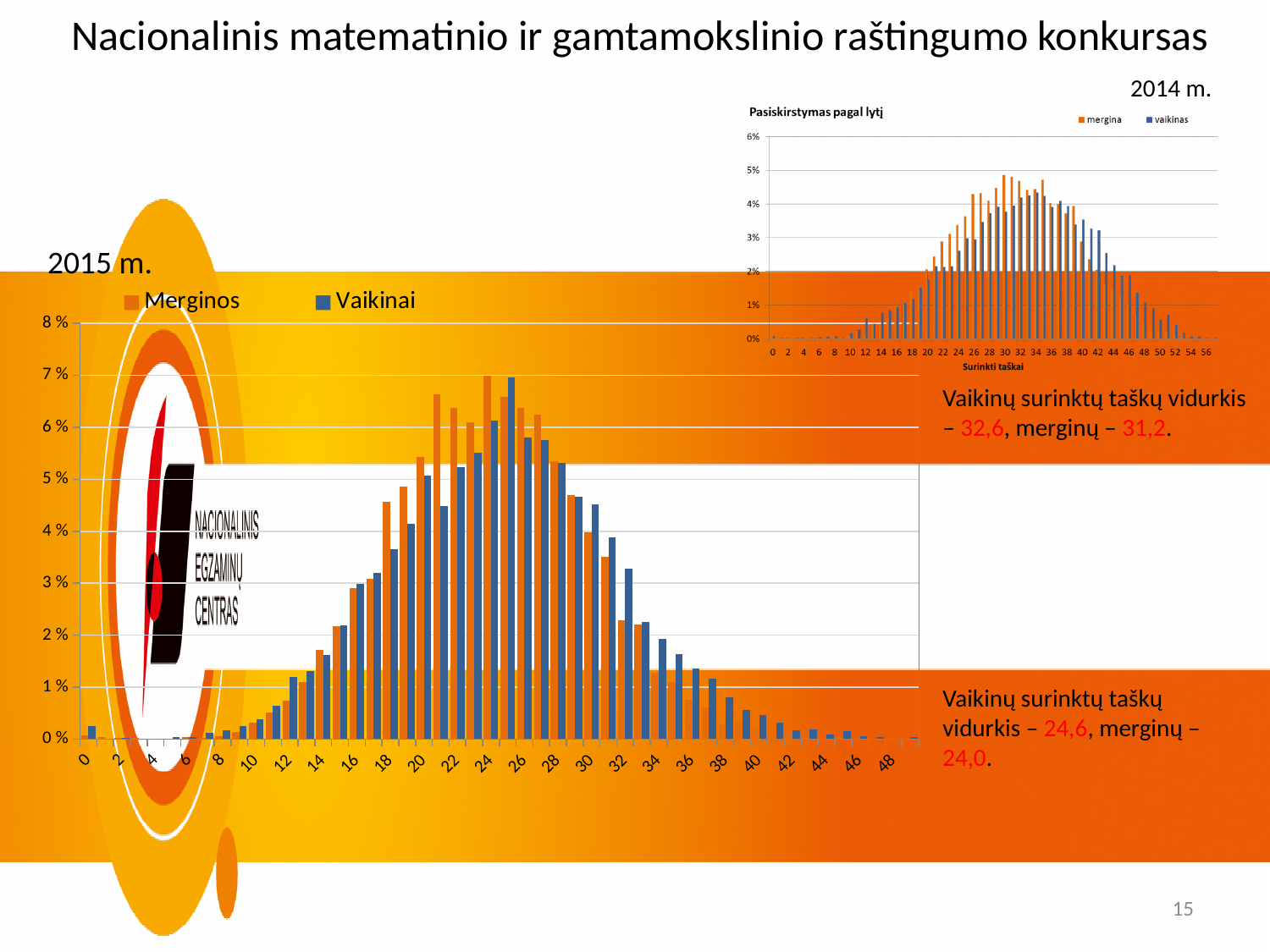
In the large 2015 m. chart, is the Vaikinai value at 40 points greater or less than 1 %? less In the large 2015 m. chart, at which score does the Merginos series reach its highest bar? 24 In the large 2015 m. chart, at which score does the Vaikinai series reach its highest bar? 25 What kind of chart is the large 2015 m. chart? bar chart In the large 2015 m. chart, at 18 points, which series has the larger value, Merginos or Vaikinai? Merginos What are the two legend entries of the large 2015 m. chart? Merginos, Vaikinai In the large 2015 m. chart, is the Vaikinai value at 25 points greater or less than 6 %? greater What is the title of the small 2014 m. chart in the top right? Pasiskirstymas pagal lytį In the large 2015 m. chart, is the Merginos value at 18 points greater or less than 4 %? greater How many series does the legend of the large 2015 m. chart list? 2